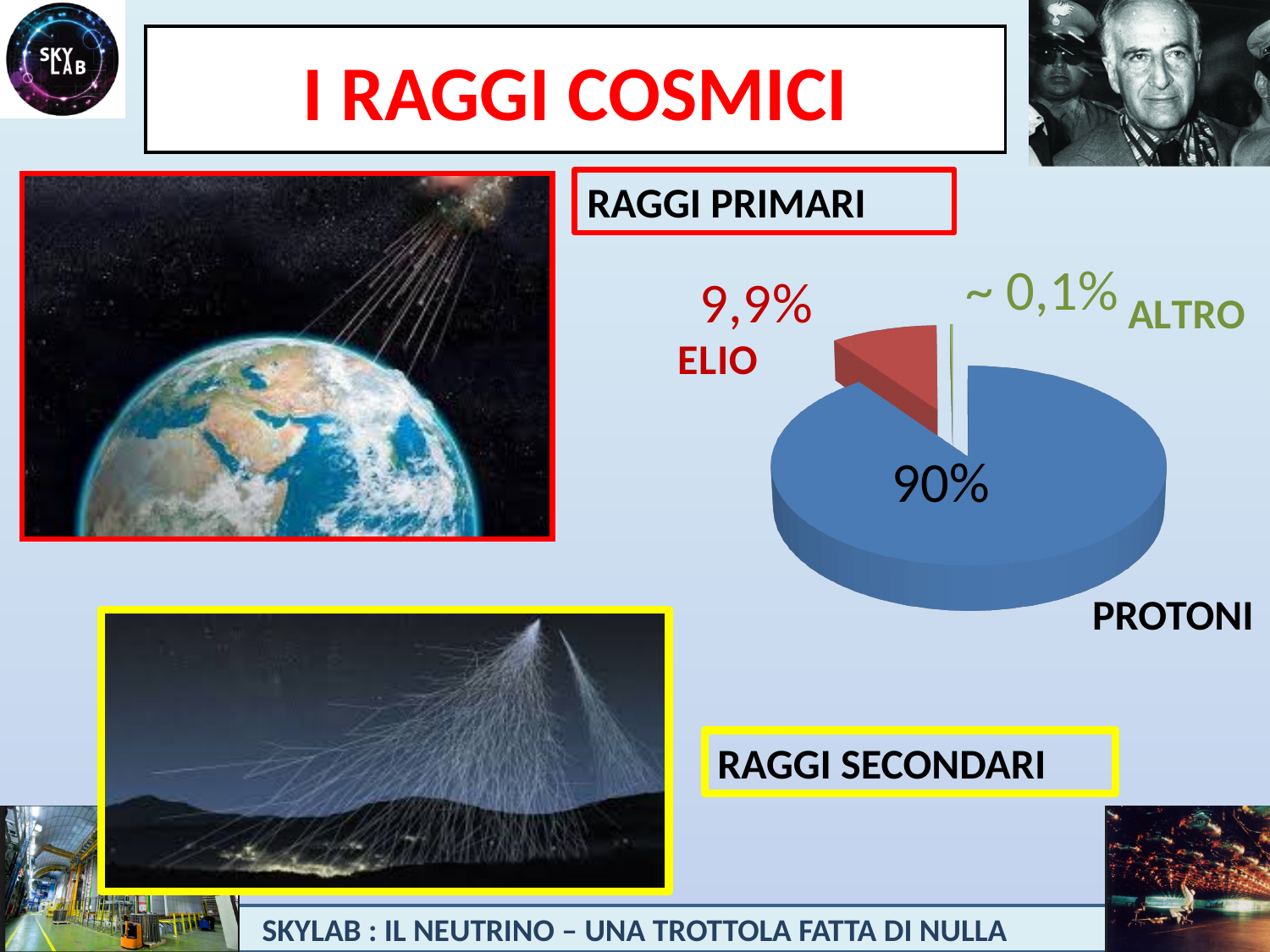
Which slice is larger in the pie chart, ELIO or ALTRO? ELIO What is the difference between the PROTONI share and the ELIO share in the pie chart? 80,1% What colour is the PROTONI slice in the pie chart? blue What share of the pie chart do PROTONI represent? 90% Which slice is larger in the pie chart, PROTONI or ELIO? PROTONI Which category has the largest slice of the pie chart? PROTONI What kind of chart is shown on the slide? pie chart How many slices does the pie chart have? 3 What percentage of the pie chart is labelled ELIO? 9,9% Which category has the smallest slice of the pie chart? ALTRO What percentage of the pie chart is labelled PROTONI? 90% What colour is the ELIO slice in the pie chart? red